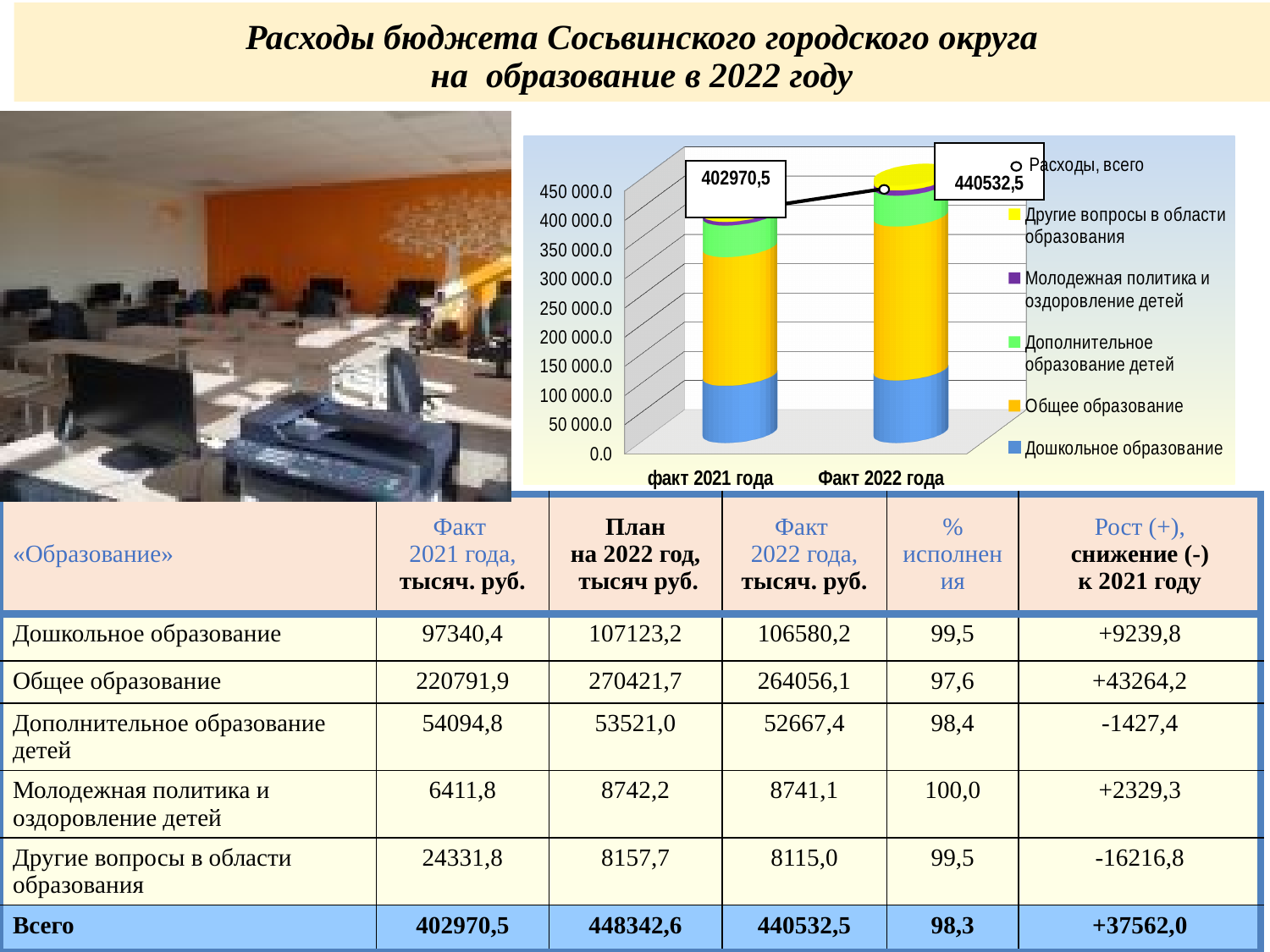
What is the value of the 'Расходы, всего' data label for 'Факт 2022 года'? 440532,5 Which legend entry is shown in blue? Дошкольное образование Is the 'Общее образование' segment for 'Факт 2022 года' greater or less than 200 000.0? greater By how much does the 'Расходы, всего' value for 'Факт 2022 года' exceed the value for 'факт 2021 года'? 37562,0 Which has the larger 'Расходы, всего' value: 'факт 2021 года' or 'Факт 2022 года'? Факт 2022 года What is the value of the 'Расходы, всего' data label for 'факт 2021 года'? 402970,5 How many entries does the chart legend list? 6 How many categories are shown on the x axis of the chart? 2 Which category on the x axis has the highest total expenditure? Факт 2022 года Is the 'Дошкольное образование' segment for 'факт 2021 года' greater or less than 150 000.0? less Do the total expenditures rise or fall from 'факт 2021 года' to 'Факт 2022 года'? Rise What kind of chart is shown on the slide? Stacked bar chart